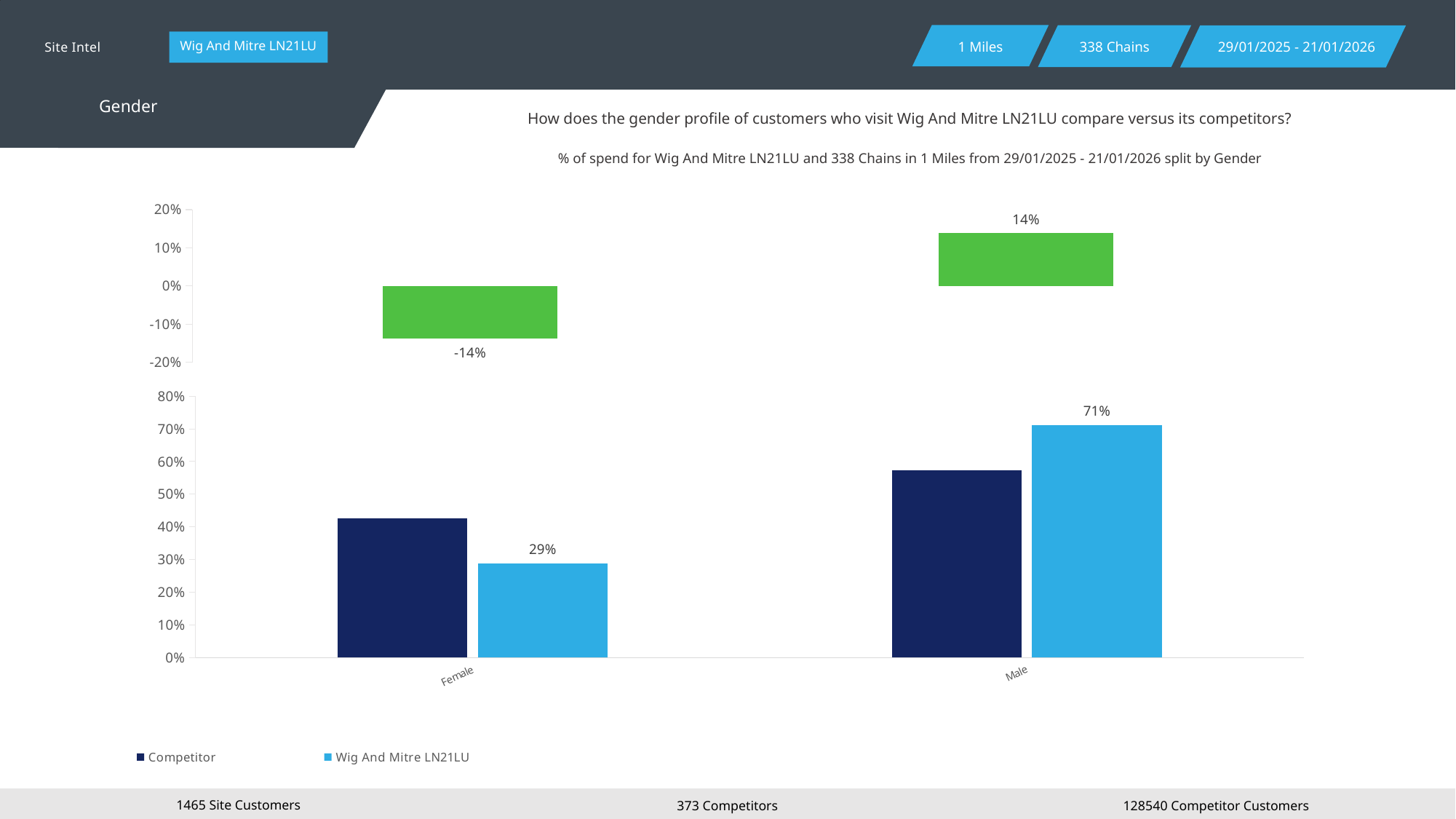
In the bottom chart, what is the difference between the Wig And Mitre LN21LU values for Male and Female? 42% How many categories are shown on the x axis of the bottom chart? 2 In the bottom chart, for Female, which is larger: the Competitor value or the Wig And Mitre LN21LU value? Competitor In the bottom chart, what is the value for Wig And Mitre LN21LU for Male? 71% In the top chart, what is the value shown for Female? -14% In the top chart, what is the value shown for Male? 14% What type of chart is the bottom chart? Bar chart In the bottom chart, is the Competitor value for Female greater or less than 50%? less In the bottom chart, what is the value for Wig And Mitre LN21LU for Female? 29% In the bottom chart, which gender has the higher value for Wig And Mitre LN21LU? Male In the bottom chart, is the Competitor value for Male greater or less than 50%? greater How many series does the legend of the bottom chart list? 2